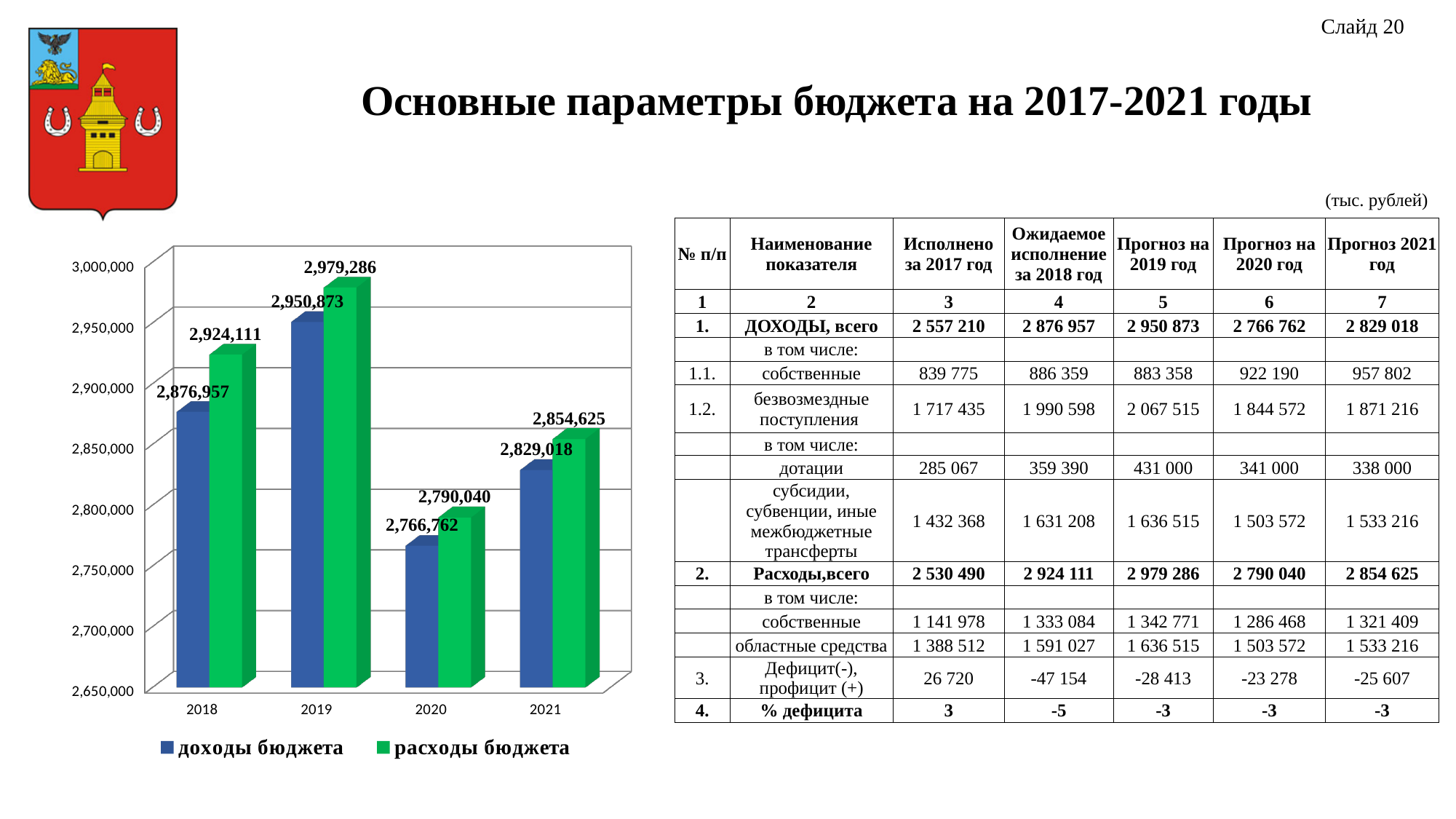
Is the value of расходы бюджета for 2020 greater or less than 2,800,000? less What is the difference between расходы бюджета and доходы бюджета for 2021 in the chart? 25,607 How many years are shown on the x axis of the chart? 4 What is the difference between расходы бюджета and доходы бюджета for 2018 in the chart? 47,154 In which year is доходы бюджета lowest in the chart? 2020 What is the value of расходы бюджета for 2020 in the chart? 2,790,040 Which is larger in the chart: доходы бюджета for 2018 or доходы бюджета for 2021? доходы бюджета for 2018 What is the value of доходы бюджета for 2019 in the chart? 2,950,873 How many series does the chart legend list? 2 What is the value of доходы бюджета for 2021 in the chart? 2,829,018 What type of chart is shown on the slide? bar chart In which year is расходы бюджета highest in the chart? 2019